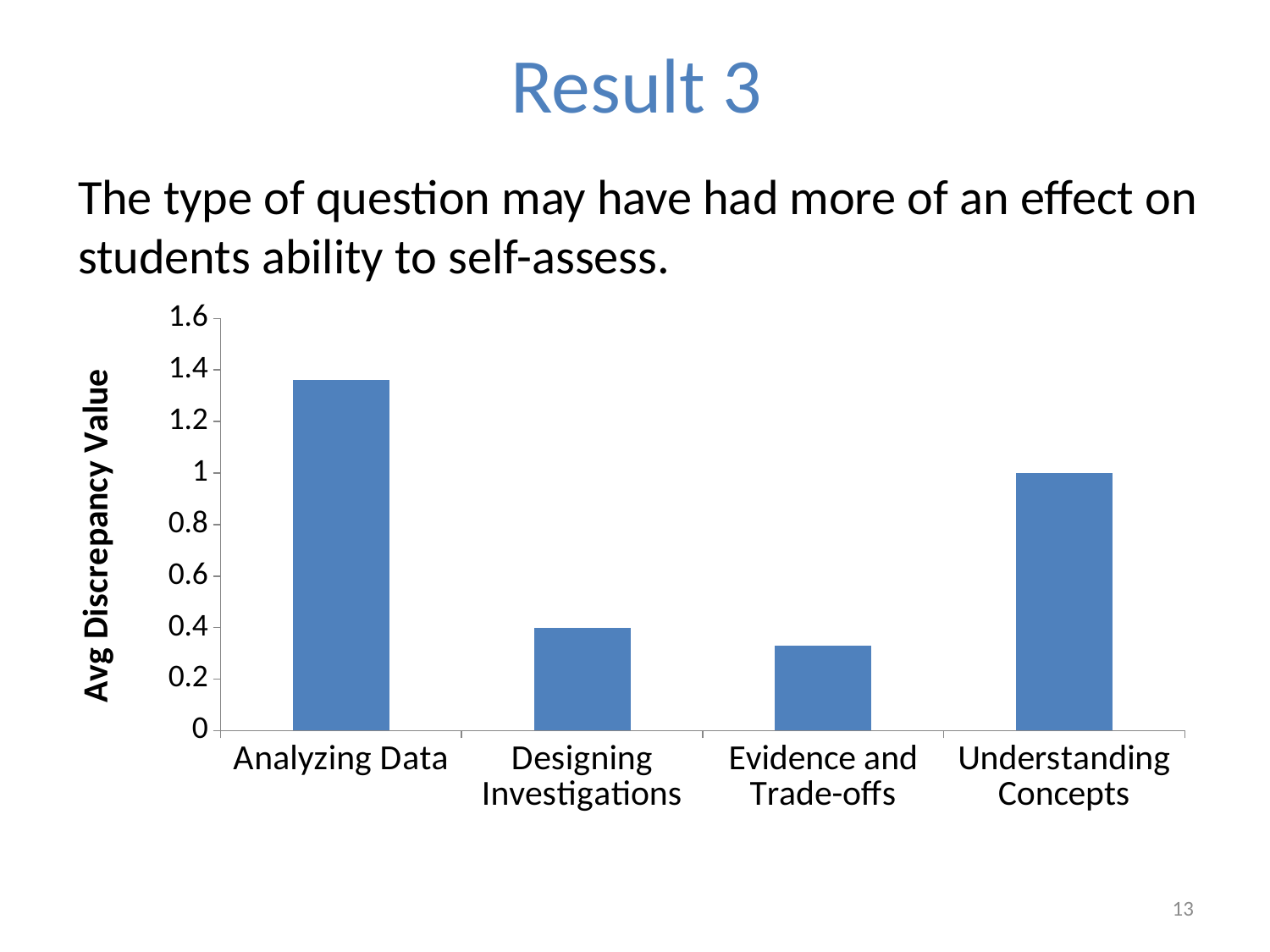
Is the value for Evidence and Trade-offs greater or less than 0.4? less Which category has the lowest Avg Discrepancy Value? Evidence and Trade-offs Which has a larger Avg Discrepancy Value, Designing Investigations or Evidence and Trade-offs? Designing Investigations Is the value for Understanding Concepts greater or less than 0.8? greater Which category has the highest Avg Discrepancy Value? Analyzing Data Which has a larger Avg Discrepancy Value, Analyzing Data or Understanding Concepts? Analyzing Data What is the label on the vertical axis of the chart? Avg Discrepancy Value What is the Avg Discrepancy Value for Understanding Concepts? 1 Is the value for Designing Investigations greater or less than 0.6? less What kind of chart is shown on the slide? bar chart How many categories are plotted on the chart? 4